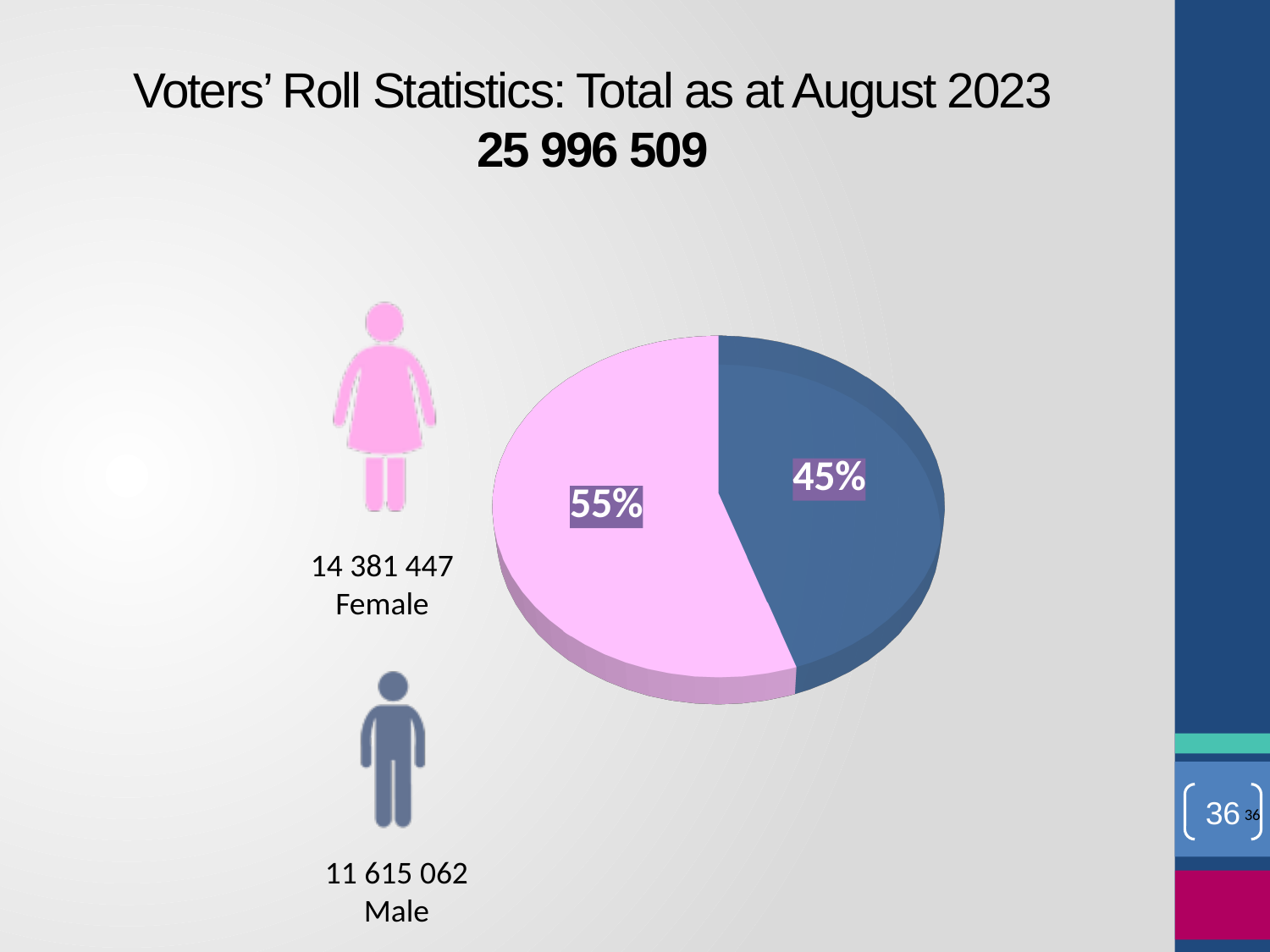
What kind of chart is shown on the slide? pie chart How many male voters are on the roll according to the slide? 11 615 062 How many slices does the pie chart have? 2 What is the total number of voters on the roll as at August 2023? 25 996 509 What colour is the slice representing Male voters? blue What share of the pie does the pink (Female) slice represent? 55% What share of the pie does the blue (Male) slice represent? 45% What is the title of the slide containing the pie chart? Voters' Roll Statistics: Total as at August 2023 How many female voters are on the roll according to the slide? 14 381 447 Which group has the smallest share of the pie? Male Which group has the larger share of the voters' roll, Female or Male? Female What is the difference in percentage points between the Female and Male shares of the pie? 10